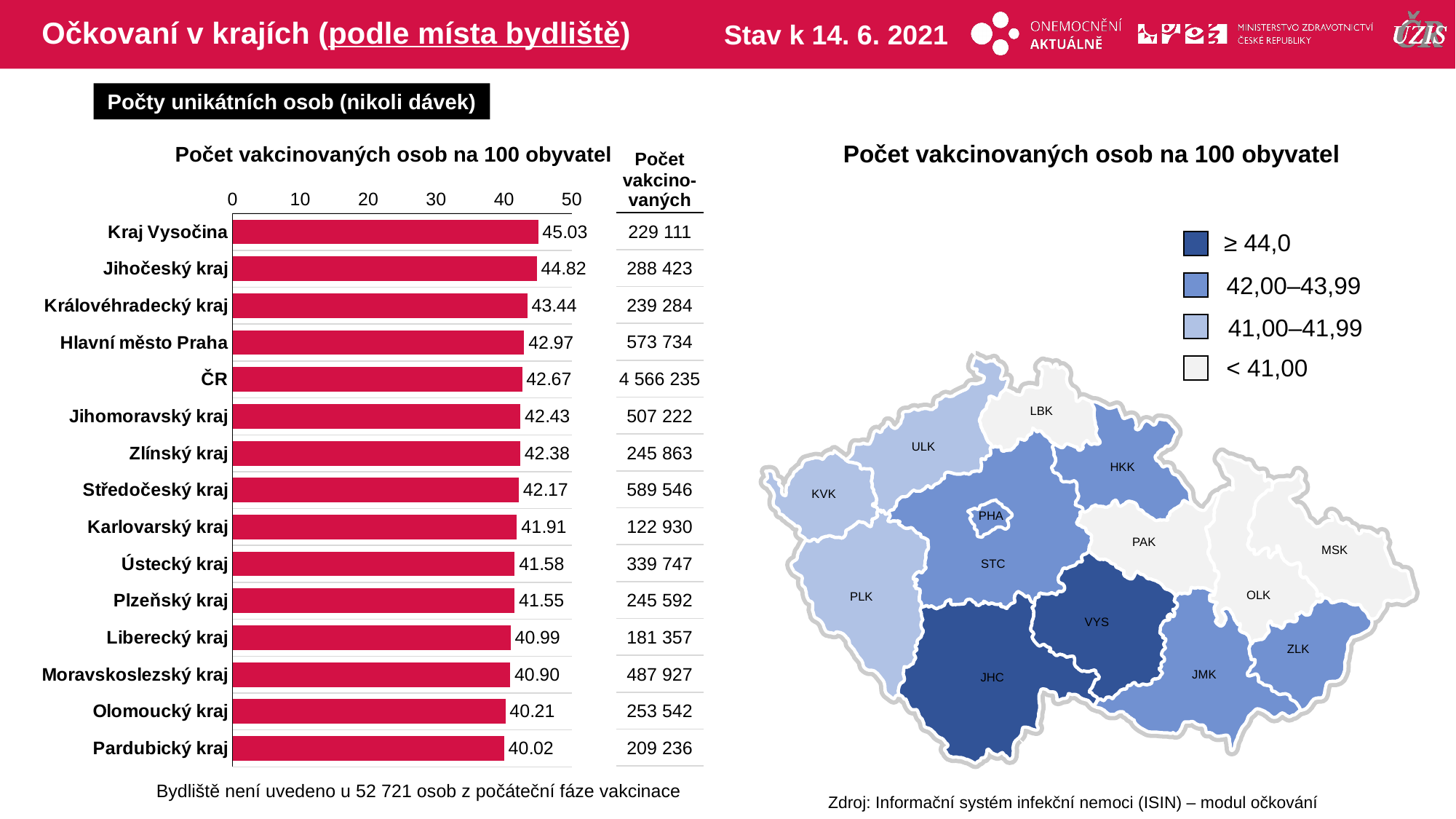
In the bar chart, which category has the lowest value? Pardubický kraj In the bar chart, is the value for Liberecký kraj greater or less than 50? less In the bar chart, what is the value for Pardubický kraj? 40.02 What is the title of the bar chart on the left? Počet vakcinovaných osob na 100 obyvatel In the bar chart, what is the value for ČR? 42.67 In the bar chart, what is the value for Kraj Vysočina? 45.03 What kind of chart is shown on the left of the slide? bar chart In the bar chart, what is the value for Hlavní město Praha? 42.97 How many bars does the bar chart show? 15 In the bar chart, which category has the highest value? Kraj Vysočina In the bar chart, which is larger: the value for Jihočeský kraj or the value for Olomoucký kraj? Jihočeský kraj In the bar chart, what is the difference between the values for Kraj Vysočina and Pardubický kraj? 5.01